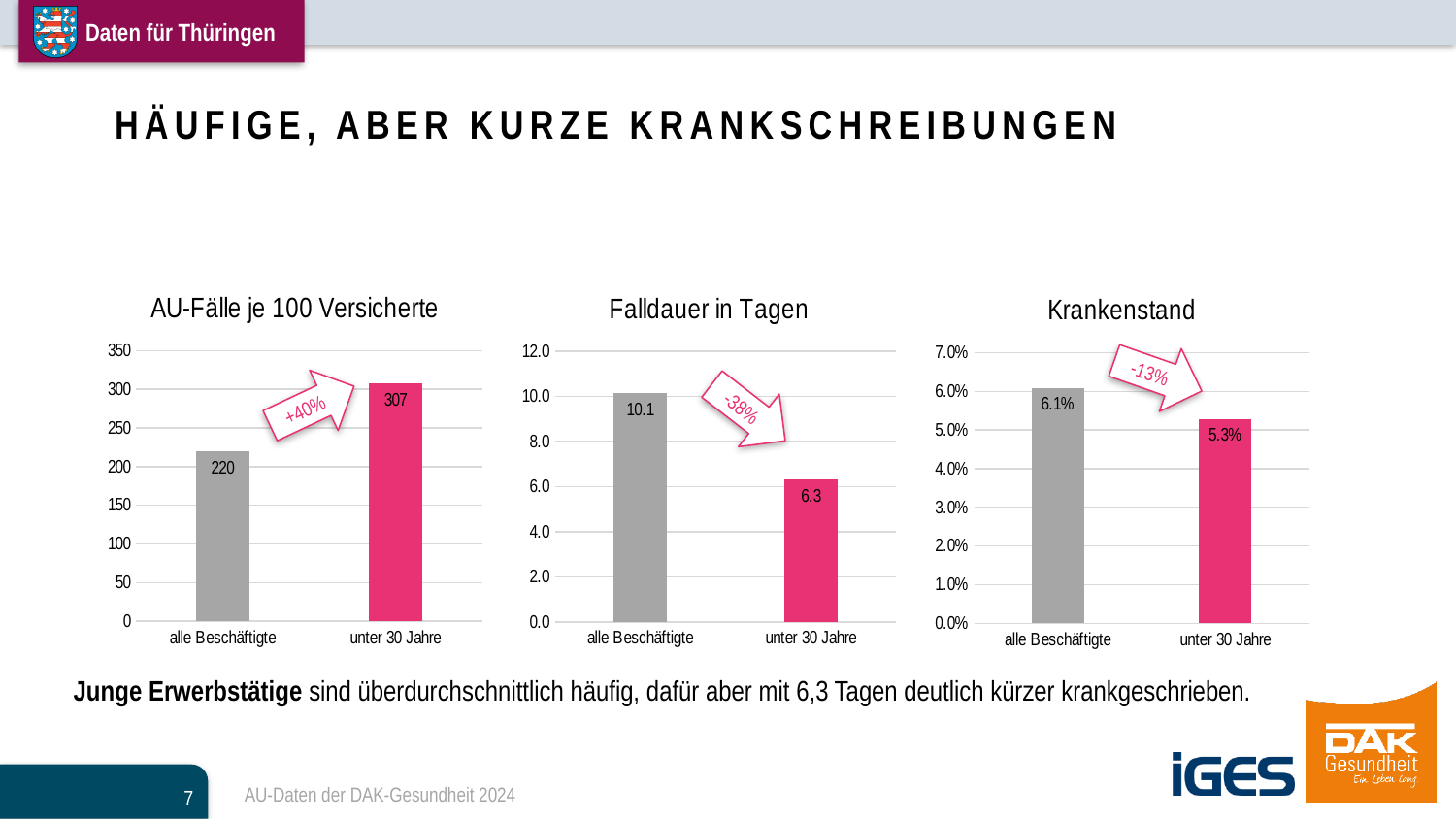
In the 'AU-Fälle je 100 Versicherte' chart, what is the value for 'alle Beschäftigte'? 220 In the 'Krankenstand' chart, which category has the higher value? alle Beschäftigte What type of chart is the 'Falldauer in Tagen' chart? bar chart In the 'Krankenstand' chart, what is the value for 'unter 30 Jahre'? 5.3% In the 'Falldauer in Tagen' chart, what is the value for 'alle Beschäftigte'? 10.1 In the 'Falldauer in Tagen' chart, what is the difference between 'alle Beschäftigte' and 'unter 30 Jahre'? 3.8 In the 'Falldauer in Tagen' chart, what is the value for 'unter 30 Jahre'? 6.3 In the 'AU-Fälle je 100 Versicherte' chart, which category has the lower value? alle Beschäftigte In the 'AU-Fälle je 100 Versicherte' chart, what is the value for 'unter 30 Jahre'? 307 In the 'Falldauer in Tagen' chart, is the value for 'alle Beschäftigte' larger or smaller than the value for 'unter 30 Jahre'? larger How many categories does the 'Krankenstand' chart show? 2 In the 'AU-Fälle je 100 Versicherte' chart, what is the difference between 'unter 30 Jahre' and 'alle Beschäftigte'? 87